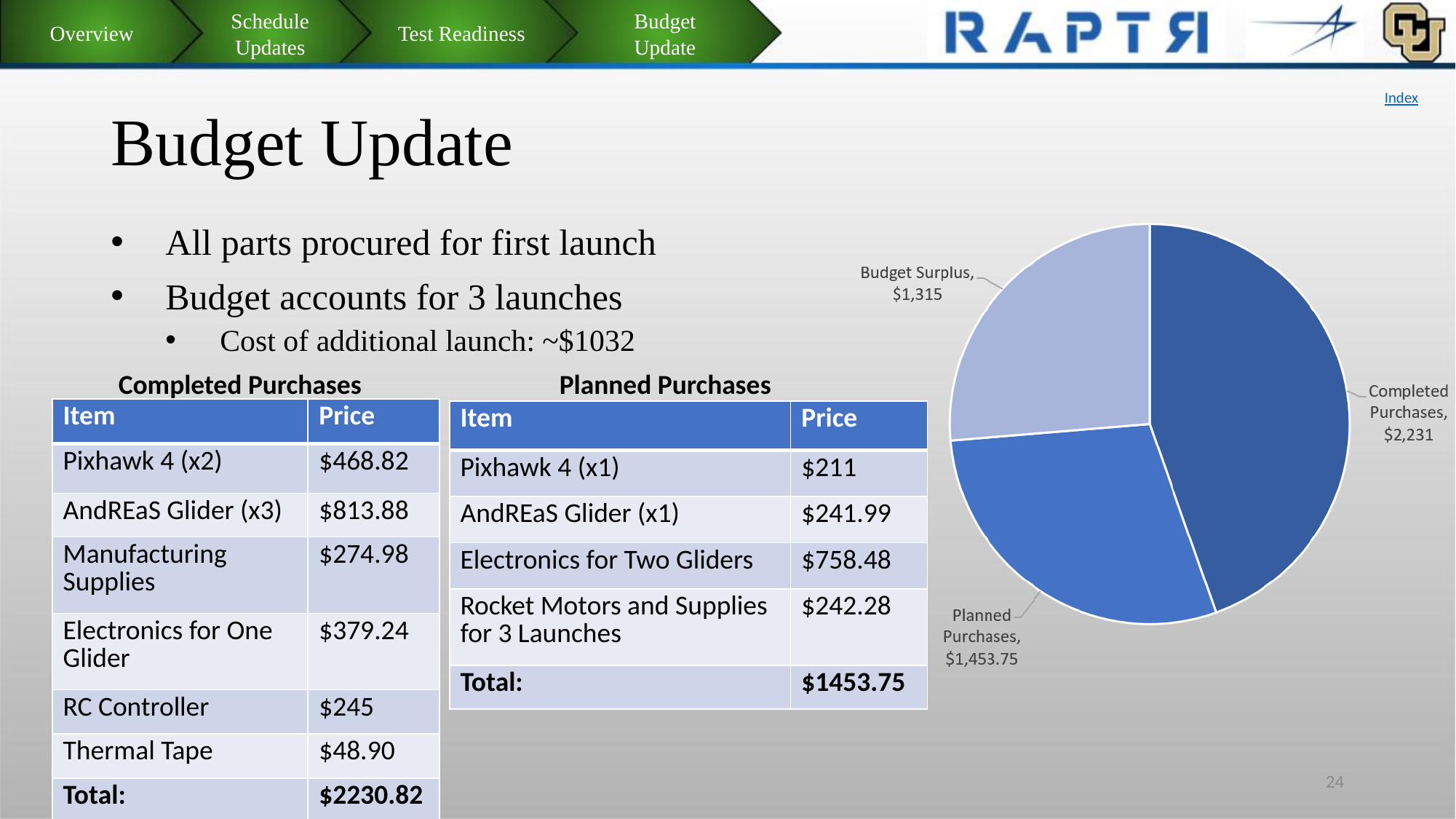
In the pie chart, which is larger: Completed Purchases or Planned Purchases? Completed Purchases What is the value of the Completed Purchases slice in the pie chart? $2,231 Which slice of the pie chart is the smallest? Budget Surplus Which slice of the pie chart is the largest? Completed Purchases What type of chart is shown on the slide? pie chart In the pie chart, what is the difference between Completed Purchases and Planned Purchases? $777.25 What is the sum of all three slices in the pie chart? $4,999.75 In the pie chart, what is the difference between Planned Purchases and Budget Surplus? $138.75 What is the value of the Planned Purchases slice in the pie chart? $1,453.75 How many slices does the pie chart have? 3 Which slice of the pie chart is shown in the darkest blue? Completed Purchases What is the value of the Budget Surplus slice in the pie chart? $1,315